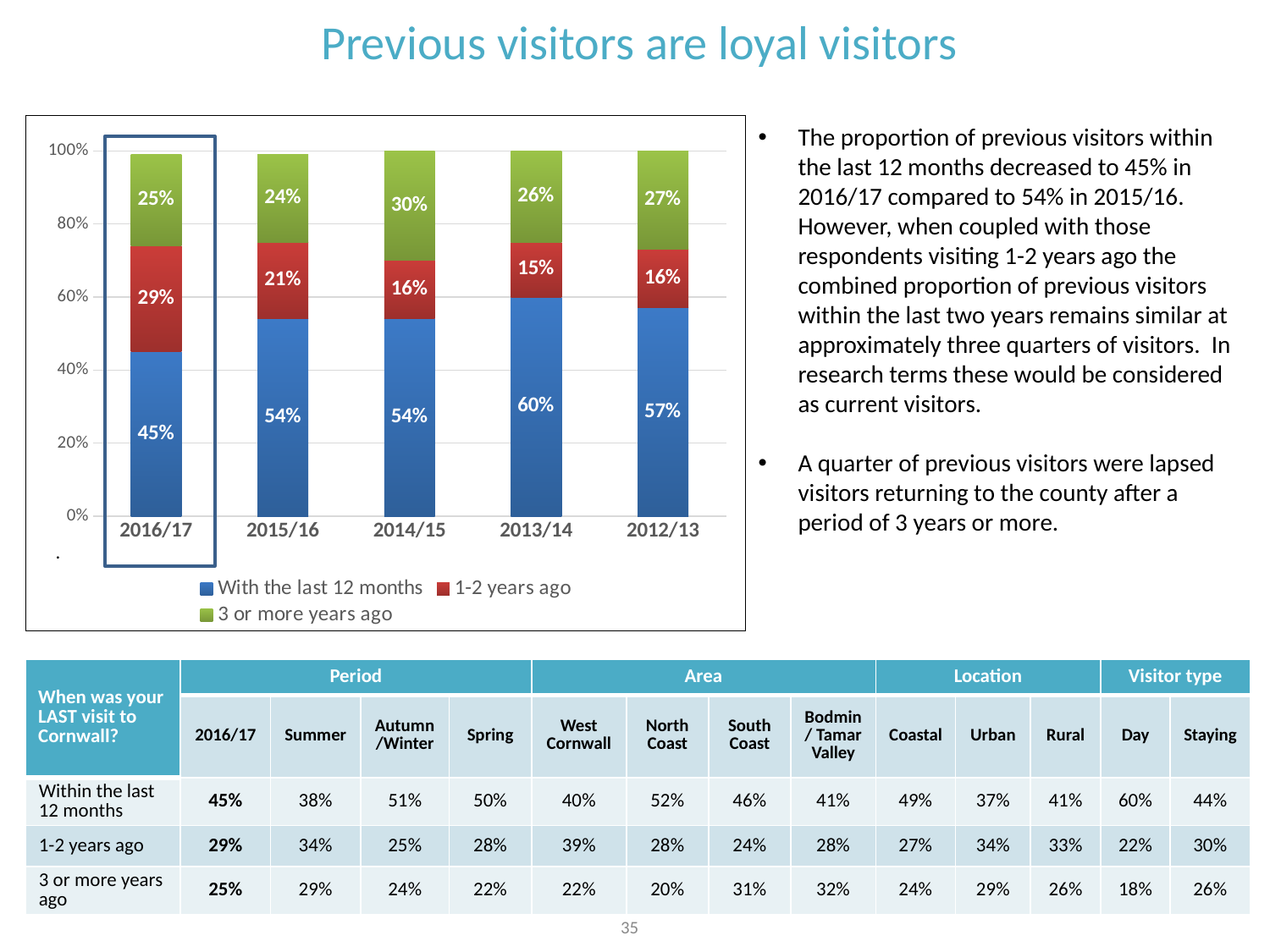
What is the value for '3 or more years ago' in 2014/15? 30% Which year has the highest value for 'With the last 12 months'? 2013/14 How many series does the chart legend list? 3 What is the value for '1-2 years ago' in 2015/16? 21% What is the value for 'With the last 12 months' in 2016/17? 45% Which year has the lowest value for 'With the last 12 months'? 2016/17 How many year categories are shown on the x axis of the chart? 5 What is the difference between the 'With the last 12 months' values for 2015/16 and 2016/17? 9% Which series is shown in green in the chart? 3 or more years ago What type of chart is shown on the slide? Stacked bar chart Which is larger: the '1-2 years ago' value for 2016/17 or for 2013/14? 2016/17 What is the total of the stacked bar for 2012/13? 100%